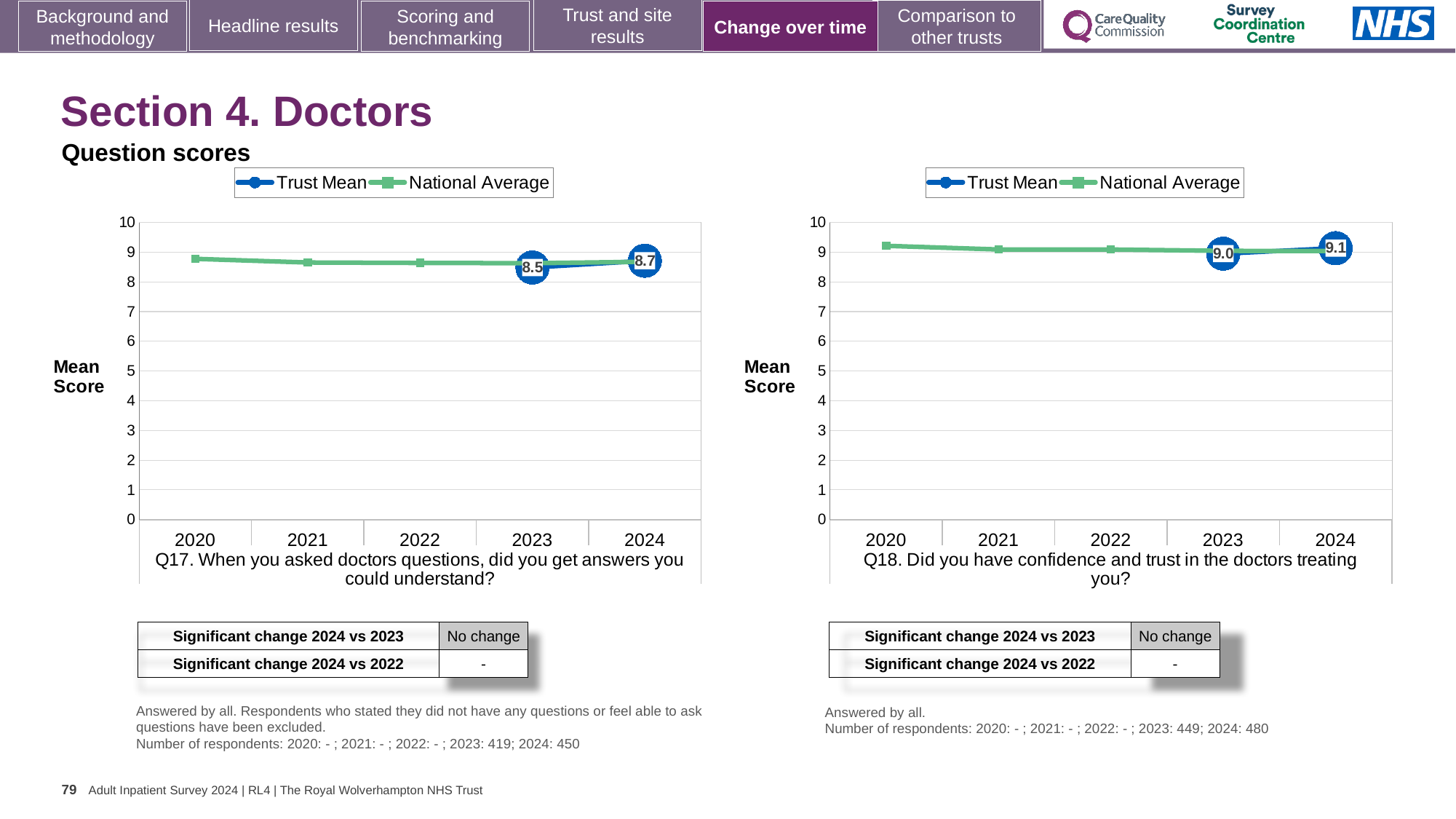
In the Q17 chart (left), does the Trust Mean rise or fall from 2023 to 2024? rise In the Q17 chart (left), by how much did the Trust Mean change from 2023 to 2024? 0.2 In the Q18 chart (right), by how much did the Trust Mean change from 2023 to 2024? 0.1 In the Q18 chart (right), what is the Trust Mean score for 2023? 9.0 What type of chart is the Q18 chart (right)? line chart How many years are shown on the x axis of the Q18 chart (right)? 5 How many series does the legend of the Q17 chart (left) list? 2 In the Q17 chart (left), what is the Trust Mean score for 2023? 8.5 In the Q18 chart (right), what is the Trust Mean score for 2024? 9.1 In the Q17 chart (left), what is the Trust Mean score for 2024? 8.7 In the Q17 chart (left), which year has the higher Trust Mean, 2023 or 2024? 2024 In the Q17 chart (left), is the National Average for 2020 greater or less than 8? greater